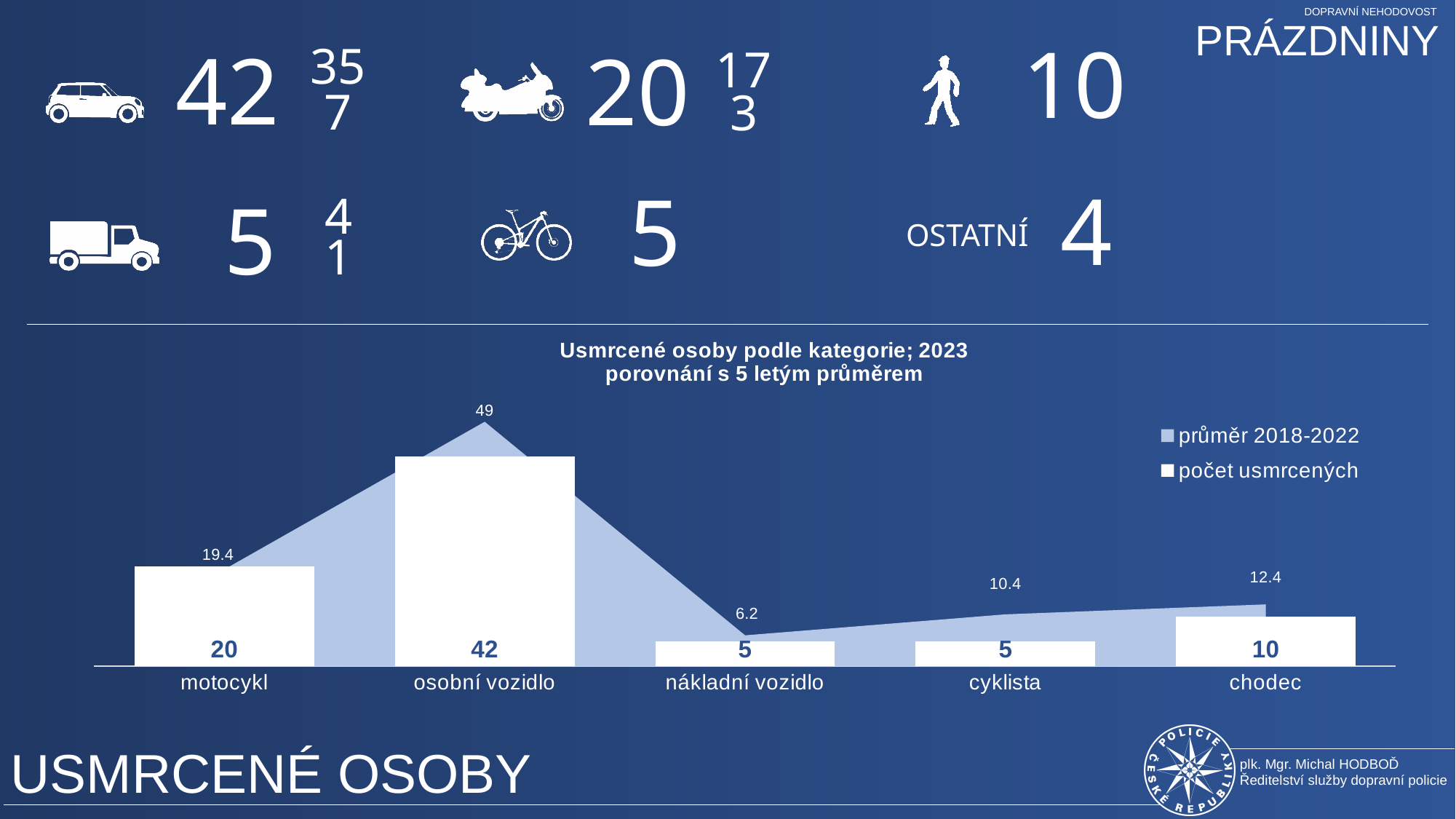
How many categories are shown on the x axis of the chart? 5 What is the 'průměr 2018-2022' value for motocykl? 19.4 Which category has a larger 'počet usmrcených' value, cyklista or chodec? chodec For motocykl, which is larger: the 'počet usmrcených' value or the 'průměr 2018-2022' value? počet usmrcených What is the 'průměr 2018-2022' value for cyklista? 10.4 How many series does the chart legend list? 2 Which category has the highest 'počet usmrcených' value? osobní vozidlo What is the 'počet usmrcených' value for osobní vozidlo? 42 For osobní vozidlo, what is the difference between the 'průměr 2018-2022' value and the 'počet usmrcených' value? 7 What is the 'průměr 2018-2022' value for chodec? 12.4 Which category has the lowest 'průměr 2018-2022' value? nákladní vozidlo For chodec, what is the difference between the 'průměr 2018-2022' value and the 'počet usmrcených' value? 2.4